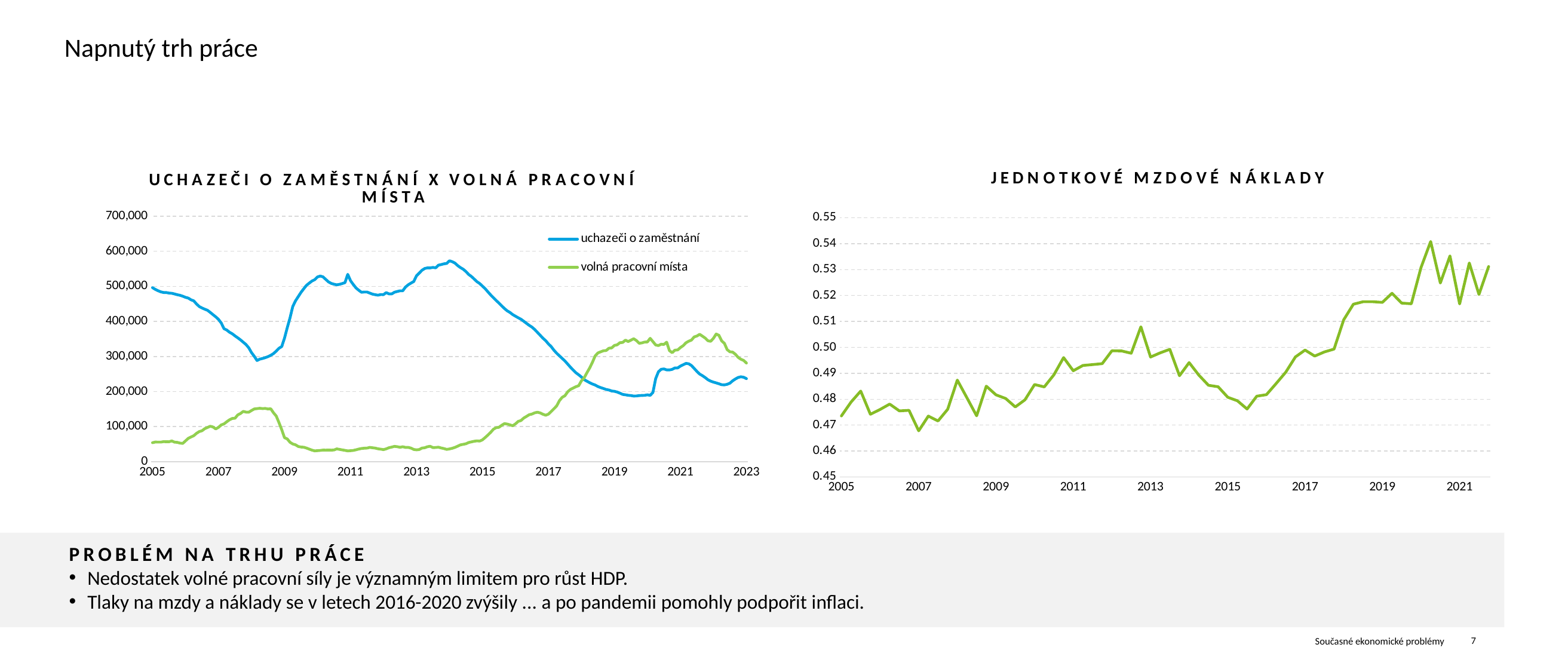
In the chart 'UCHAZEČI O ZAMĚSTNÁNÍ X VOLNÁ PRACOVNÍ MÍSTA', is the value for 'uchazeči o zaměstnání' in 2005 greater or less than 400,000? greater What kind of chart is the chart titled 'JEDNOTKOVÉ MZDOVÉ NÁKLADY'? line chart In the chart 'UCHAZEČI O ZAMĚSTNÁNÍ X VOLNÁ PRACOVNÍ MÍSTA', does the 'uchazeči o zaměstnání' line rise or fall between 2014 and 2019? fall In the chart 'UCHAZEČI O ZAMĚSTNÁNÍ X VOLNÁ PRACOVNÍ MÍSTA', is the value for 'volná pracovní místa' in 2005 greater or less than 100,000? less In the chart 'UCHAZEČI O ZAMĚSTNÁNÍ X VOLNÁ PRACOVNÍ MÍSTA', which series is drawn in green? volná pracovní místa In the chart 'UCHAZEČI O ZAMĚSTNÁNÍ X VOLNÁ PRACOVNÍ MÍSTA', which series has the larger value in 2005, 'uchazeči o zaměstnání' or 'volná pracovní místa'? uchazeči o zaměstnání What kind of chart is the chart titled 'UCHAZEČI O ZAMĚSTNÁNÍ X VOLNÁ PRACOVNÍ MÍSTA'? line chart In the chart 'UCHAZEČI O ZAMĚSTNÁNÍ X VOLNÁ PRACOVNÍ MÍSTA', is the value for 'volná pracovní místa' in 2021 greater or less than 300,000? greater In the chart 'UCHAZEČI O ZAMĚSTNÁNÍ X VOLNÁ PRACOVNÍ MÍSTA', how many series does the legend list? 2 In the chart 'UCHAZEČI O ZAMĚSTNÁNÍ X VOLNÁ PRACOVNÍ MÍSTA', which series has the larger value in 2021, 'uchazeči o zaměstnání' or 'volná pracovní místa'? volná pracovní místa In the chart 'JEDNOTKOVÉ MZDOVÉ NÁKLADY', does the line overall rise or fall from 2005 to 2021? rise